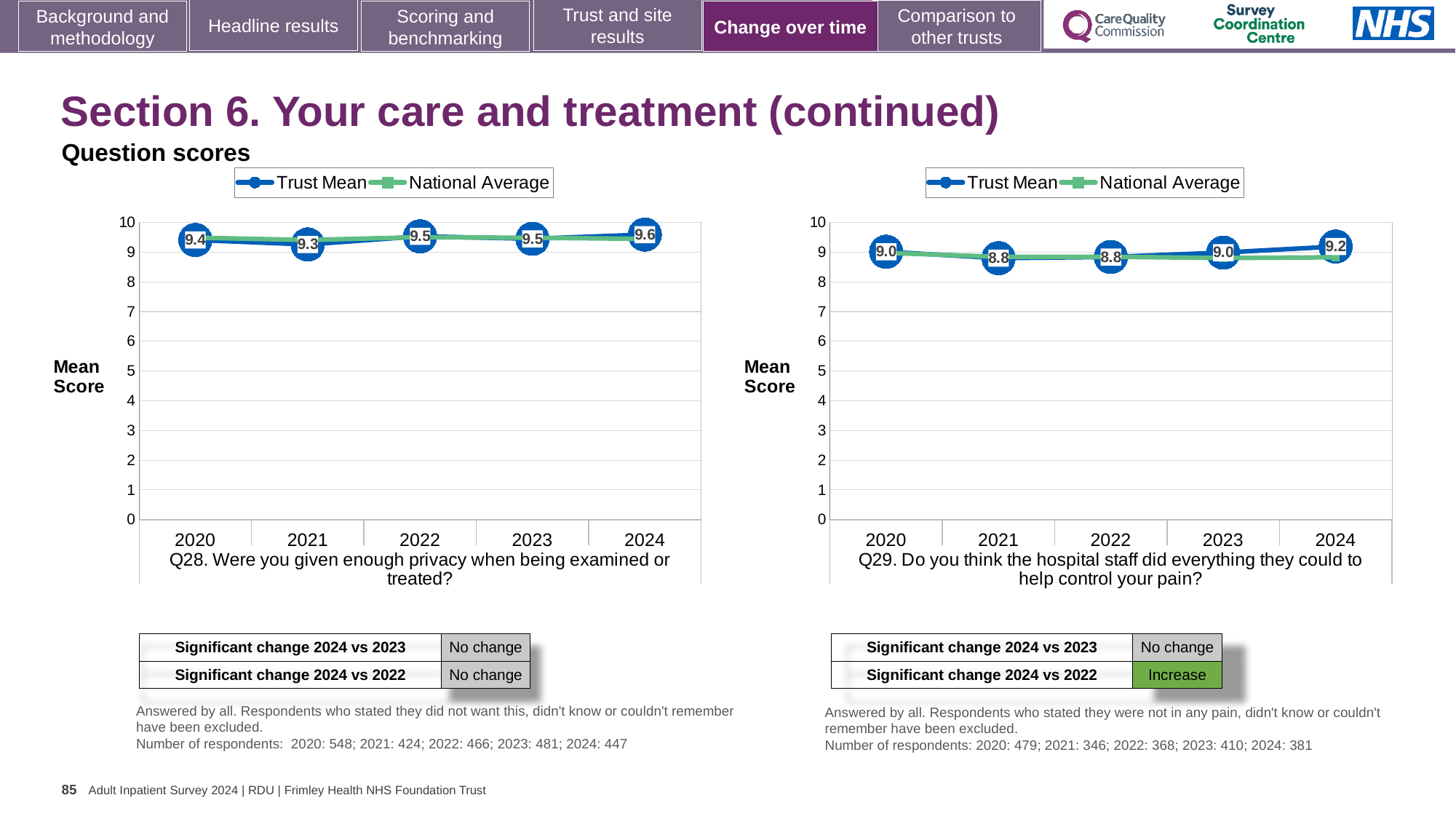
How many years are shown on the x axis of the Q28 chart (left)? 5 Which is larger: the 2024 Trust Mean in the Q28 chart (left) or the 2024 Trust Mean in the Q29 chart (right)? Q28 chart (left) In the Q28 chart (left), which year has the highest Trust Mean score? 2024 In the Q28 chart (left), which year has the lowest Trust Mean score? 2021 In the Q29 chart (right), what is the difference between the Trust Mean scores for 2024 and 2021? 0.4 In the Q29 chart (right), is the National Average value for 2024 greater or less than 8? greater What kind of chart is the Q28 chart (left)? Line chart In the Q28 chart (left), what is the Trust Mean score for 2024? 9.6 How many series does the legend of the Q29 chart (right) list? 2 In the Q28 chart (left), what is the difference between the Trust Mean scores for 2024 and 2020? 0.2 In the Q29 chart (right), what is the Trust Mean score for 2021? 8.8 In the Q29 chart (right), which year has the highest Trust Mean score? 2024